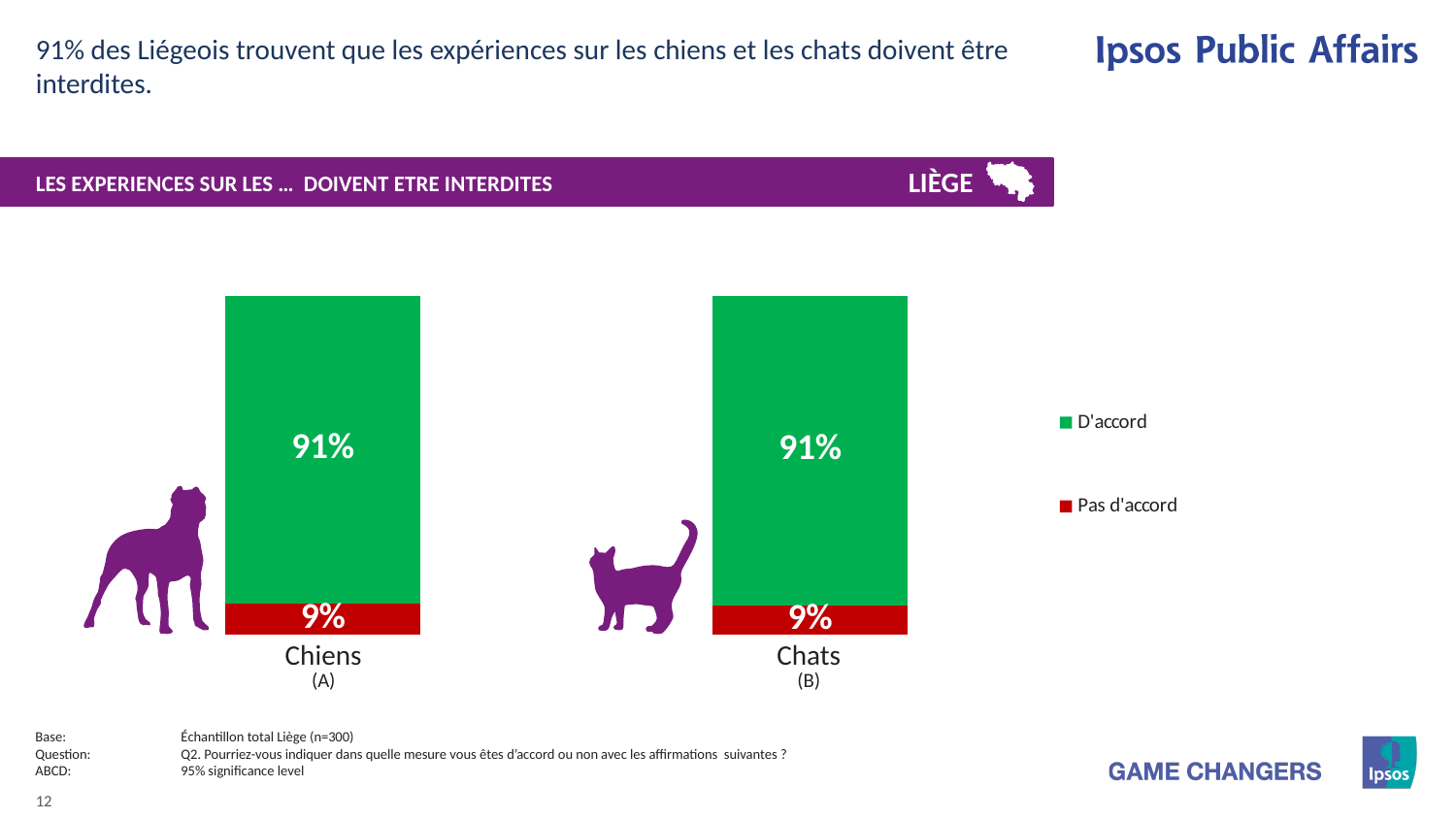
How many series does the legend list? 2 Which is larger for Chats, D'accord or Pas d'accord? D'accord Which series is shown in green in the legend? D'accord What is the value for D'accord for Chiens? 91% What is the total of the stacked bar for Chiens? 100% What is the value for Pas d'accord for Chiens? 9% What is the title of the chart? LES EXPERIENCES SUR LES … DOIVENT ETRE INTERDITES How many categories are shown on the x axis? 2 What is the difference between D'accord and Pas d'accord for Chiens? 82% What is the value for Pas d'accord for Chats? 9% What is the value for D'accord for Chats? 91% What kind of chart is shown on the slide? Stacked bar chart